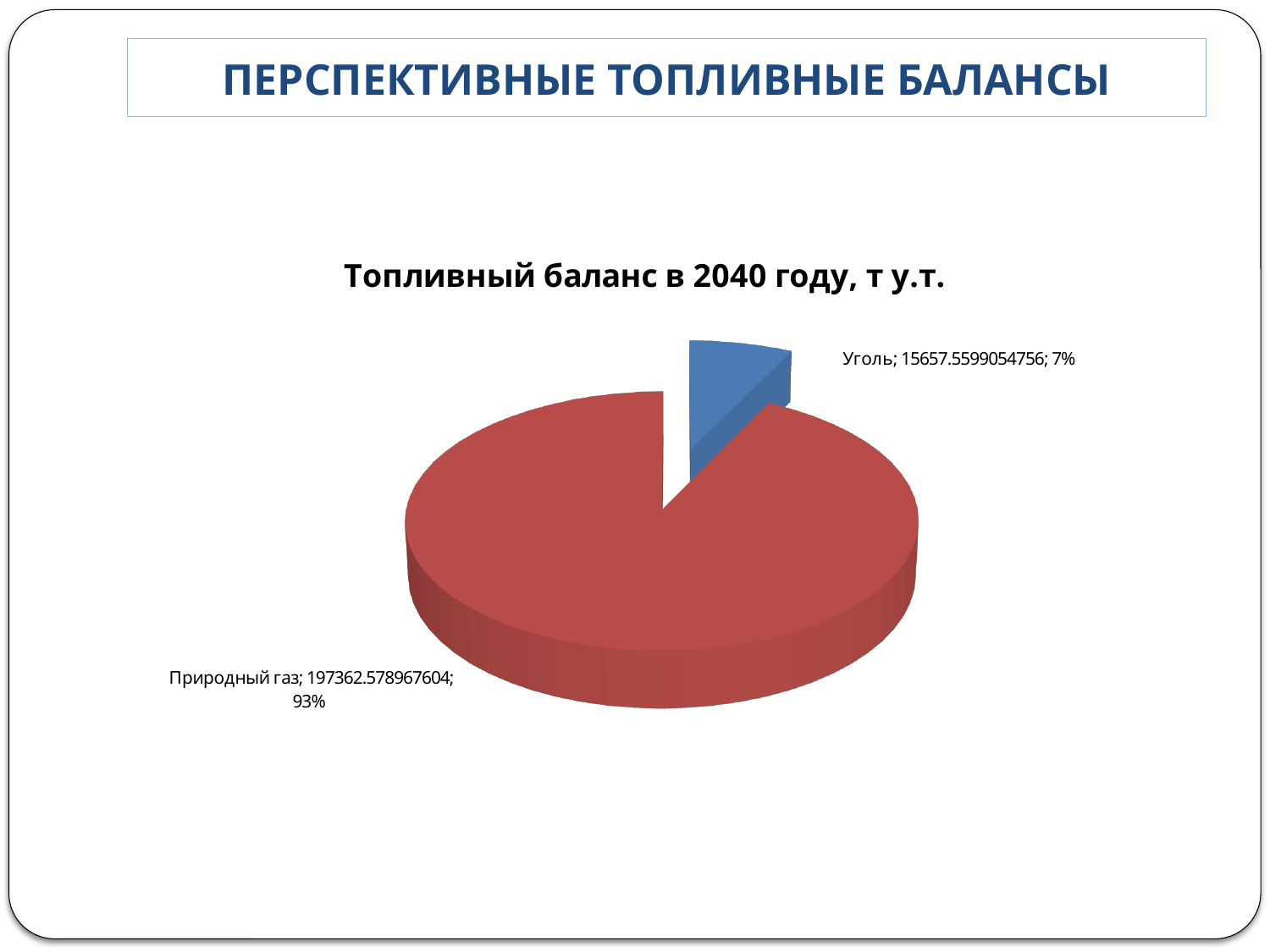
How many slices does the pie chart have? 2 Which category has the smallest slice? Уголь What is the value for Уголь? 15657.5599054756 What kind of chart is shown on the slide? Pie chart Which is larger, the value for Природный газ or the value for Уголь? Природный газ What share of the pie does Природный газ represent? 93% What is the title of the chart? Топливный баланс в 2040 году, т у.т. Which category has the largest slice? Природный газ What colour is the slice for Уголь? Blue What is the difference in percentage share between Природный газ and Уголь? 86% What is the value for Природный газ? 197362.578967604 What share of the pie does Уголь represent? 7%